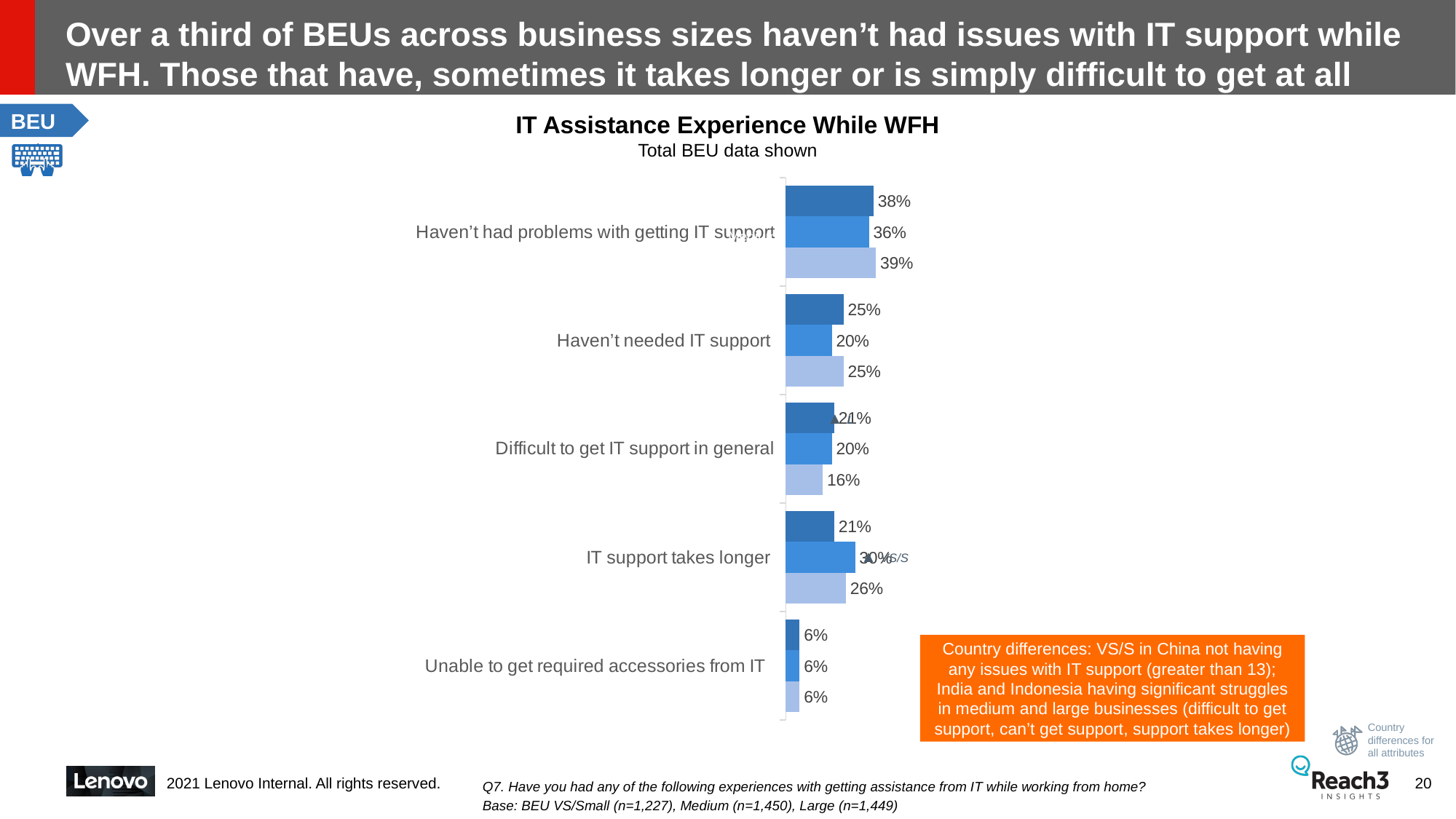
What is the value of the bottom (light blue) bar for 'Haven't had problems with getting IT support'? 39% What value is shown for each of the three bars for 'Unable to get required accessories from IT'? 6% What is the value of the top (dark blue) bar for 'Haven't had problems with getting IT support'? 38% What is the value of the light blue bar for 'Difficult to get IT support in general'? 16% How many bars are shown for each category on the chart? 3 What is the value of the middle bar for 'Haven't needed IT support'? 20% Which category has the highest values on the chart? Haven't had problems with getting IT support What is the difference between the top bar (25%) and the middle bar (20%) for 'Haven't needed IT support'? 5 percentage points How many categories are plotted on the chart? 5 What kind of chart is shown on the slide? Bar chart Which category has the lowest values on the chart? Unable to get required accessories from IT What is the value of the light blue bar for 'IT support takes longer'? 26%